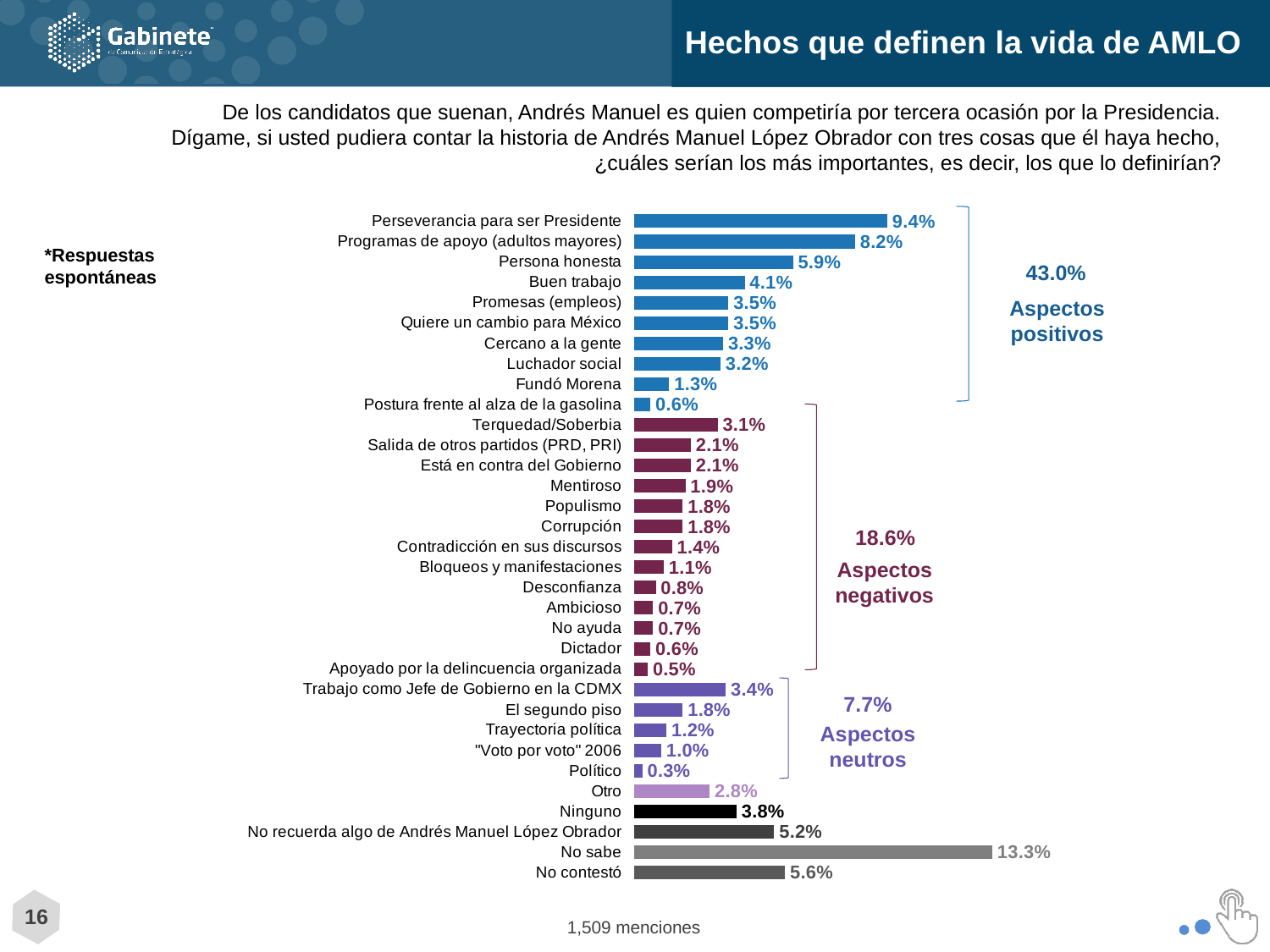
What percentage is shown for "Trabajo como Jefe de Gobierno en la CDMX"? 3.4% Which category has the highest value in the chart? No sabe Which category has the lowest value in the chart? Político What percentage is shown for "Terquedad/Soberbia"? 3.1% How many mentions does the note at the bottom of the slide report? 1,509 menciones What kind of chart is shown on the slide? Bar chart What total percentage is shown for the "Aspectos negativos" group? 18.6% Which is larger, the value for "Persona honesta" or the value for "No contestó"? Persona honesta What percentage is shown for "No sabe"? 13.3% What percentage is shown for "Perseverancia para ser Presidente"? 9.4% How many categories are plotted in the chart? 33 What is the difference between the values for "Perseverancia para ser Presidente" and "Programas de apoyo (adultos mayores)"? 1.2%